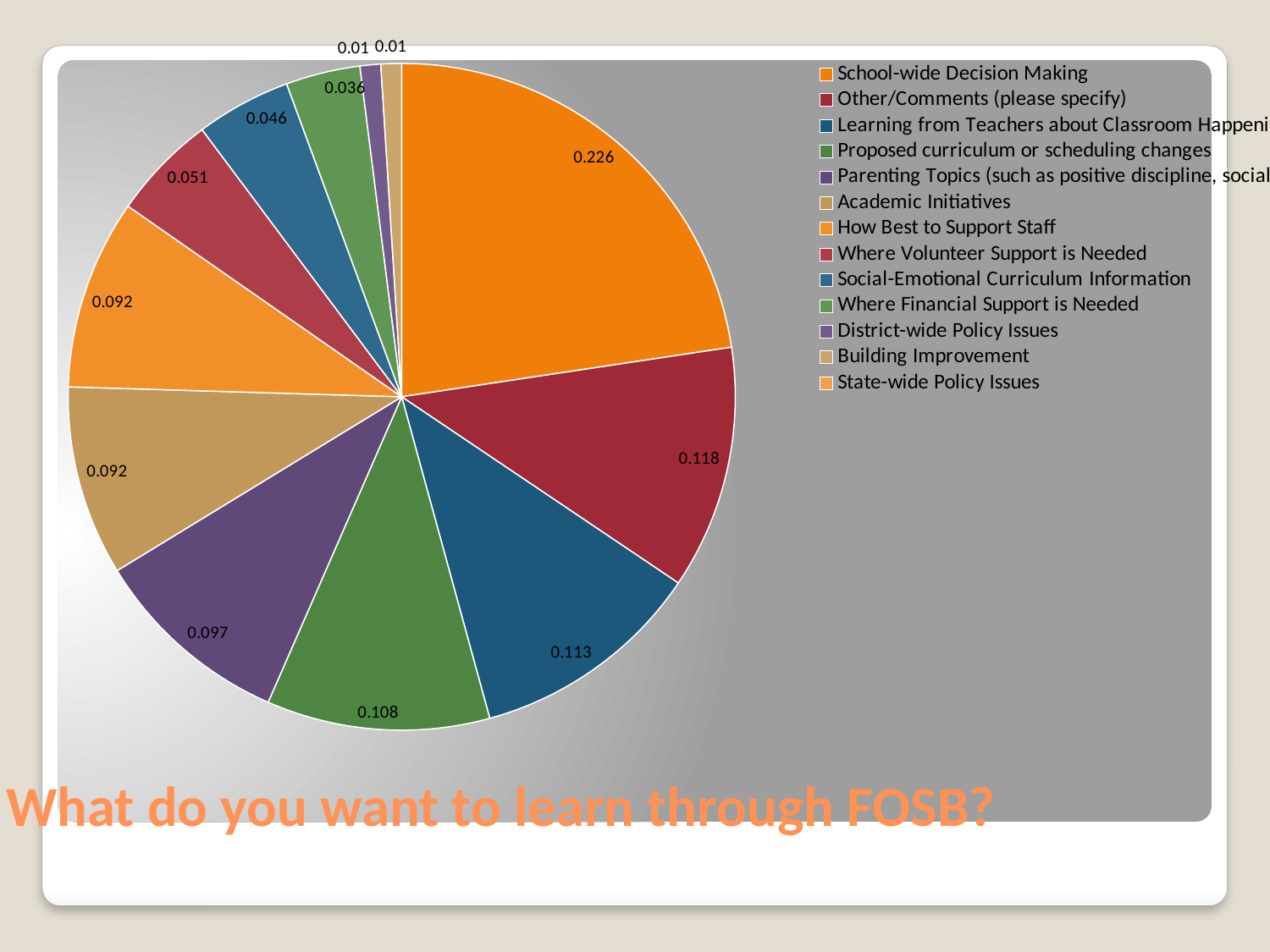
What is the value for Other/Comments (please specify)? 0.118 What is the value for School-wide Decision Making? 0.226 What is the value for Proposed curriculum or scheduling changes? 0.108 What is the value for Where Volunteer Support is Needed? 0.051 Which category has the largest slice of the pie? School-wide Decision Making What is the title of the slide? What do you want to learn through FOSB? Which is larger, the value for Social-Emotional Curriculum Information or the value for Where Volunteer Support is Needed? Where Volunteer Support is Needed What is the value for Parenting Topics? 0.097 How many categories does the legend list? 13 What kind of chart is shown on the slide? pie chart What is the value for Where Financial Support is Needed? 0.036 What is the difference between the values for School-wide Decision Making and Other/Comments (please specify)? 0.108